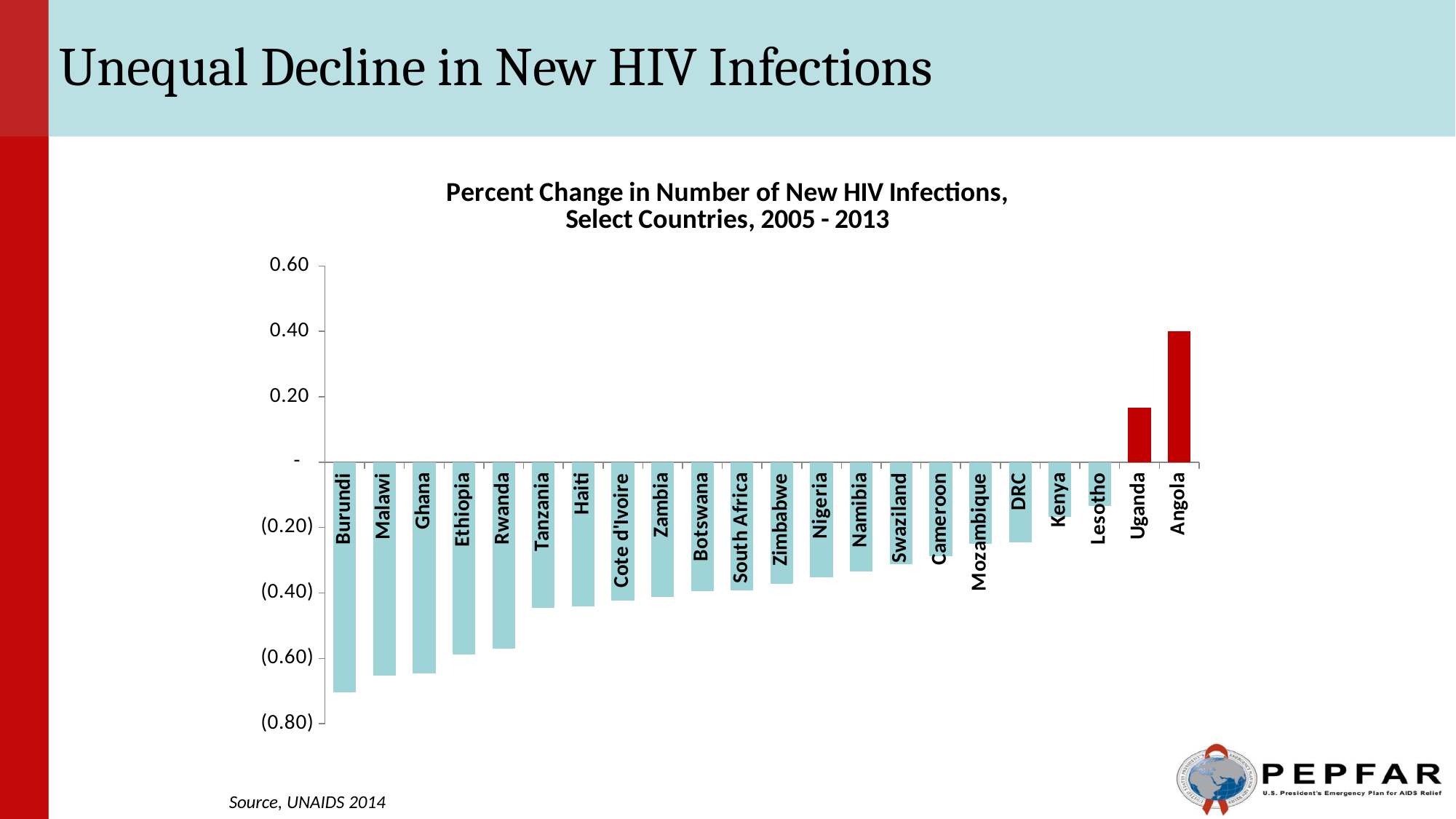
Is the value for Burundi greater or less than (0.60)? less Is the value for Uganda greater or less than 0.20? less Do the values rise or fall from left to right along the x axis? rise Is the value for Angola greater or less than 0.20? greater How many countries show a positive percent change in new HIV infections? 2 Which country has the highest percent change in new HIV infections? Angola Which has the larger value, Rwanda or Tanzania? Tanzania Which countries' bars are coloured red in the chart? Uganda and Angola Which country has the lowest percent change in new HIV infections? Burundi How many countries are shown on the x axis of the chart? 22 What kind of chart is shown on the slide? bar chart